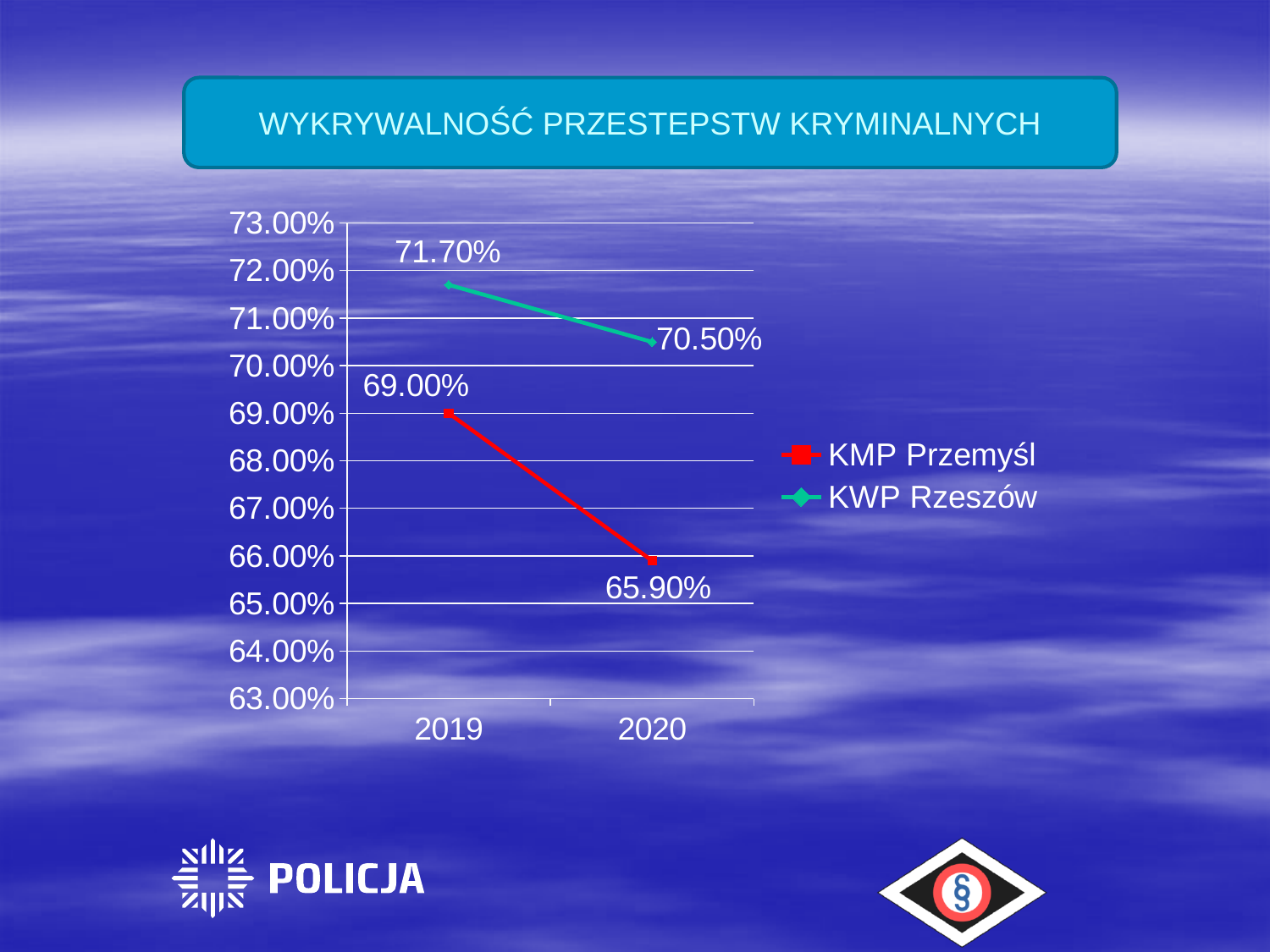
How many series does the legend list? 2 What is the value for KMP Przemyśl in 2019? 69.00% How many years are shown on the x axis? 2 What is the value for KMP Przemyśl in 2020? 65.90% What kind of chart is shown on the slide? line chart By how much did the KMP Przemyśl value drop from 2019 to 2020? 3.10% Which series has the higher value in 2020, KMP Przemyśl or KWP Rzeszów? KWP Rzeszów What is the value for KWP Rzeszów in 2019? 71.70% Does the value for KMP Przemyśl rise or fall from 2019 to 2020? fall What is the title of the chart on the slide? WYKRYWALNOŚĆ PRZESTEPSTW KRYMINALNYCH What is the difference between the KWP Rzeszów and KMP Przemyśl values in 2020? 4.60% What is the value for KWP Rzeszów in 2020? 70.50%